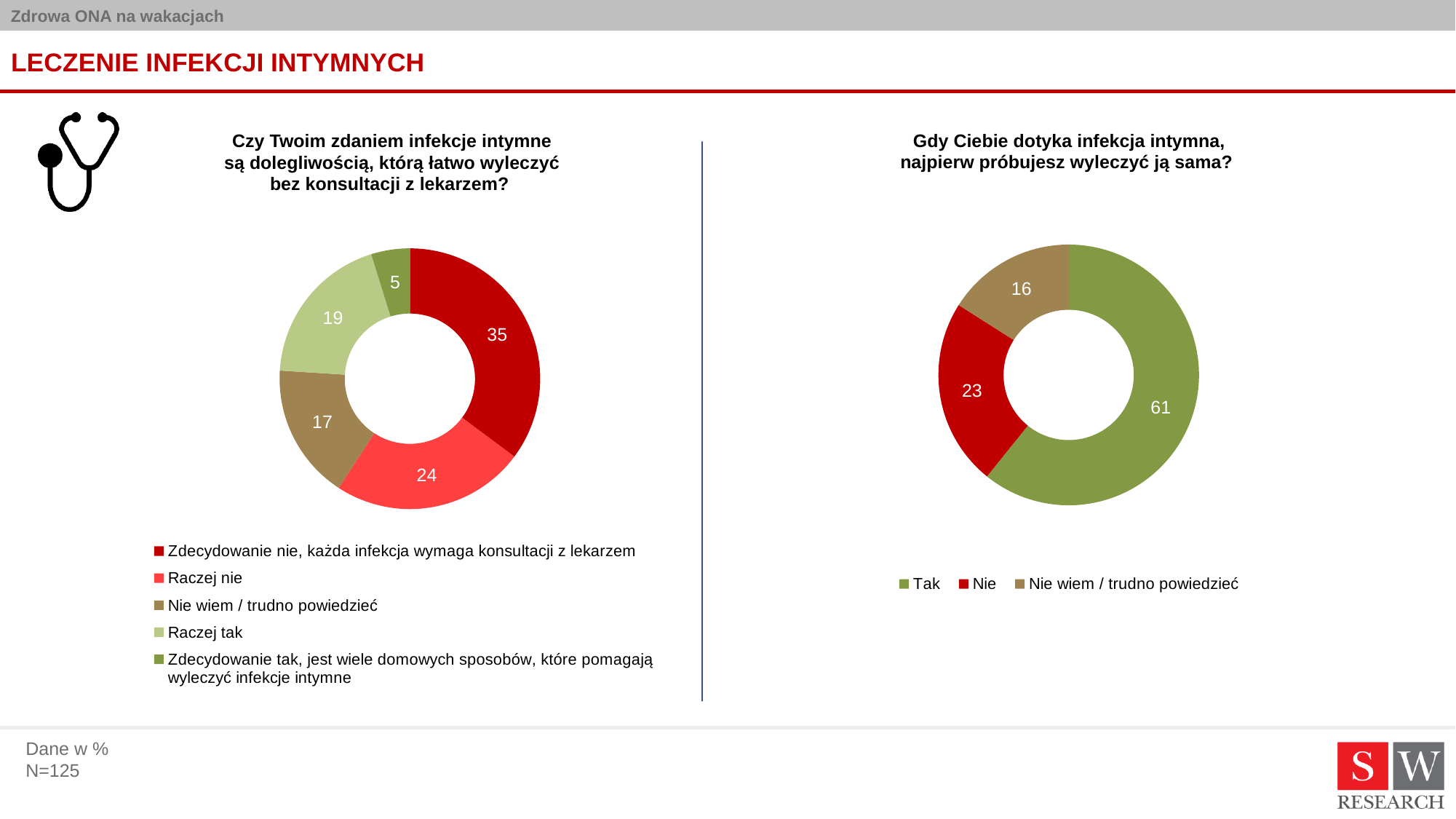
In the left chart, which category has the smallest slice? Zdecydowanie tak, jest wiele domowych sposobów, które pomagają wyleczyć infekcje intymne In the left chart, what is the value for "Raczej nie"? 24 In the left chart, what is the value for "Zdecydowanie nie, każda infekcja wymaga konsultacji z lekarzem"? 35 In the left chart, which category has the largest slice? Zdecydowanie nie, każda infekcja wymaga konsultacji z lekarzem In the right chart, what is the value for "Nie"? 23 What kind of chart is the right chart? Donut (pie) chart In the right chart, which category has the largest slice? Tak In the right chart, what is the difference between the values for "Tak" and "Nie"? 38 In the left chart, what is the difference between the values for "Raczej tak" and "Nie wiem / trudno powiedzieć"? 2 In the right chart, which is larger: "Nie" or "Nie wiem / trudno powiedzieć"? Nie In the right chart, what is the value for "Tak"? 61 In the left chart, how many categories does the legend list? 5